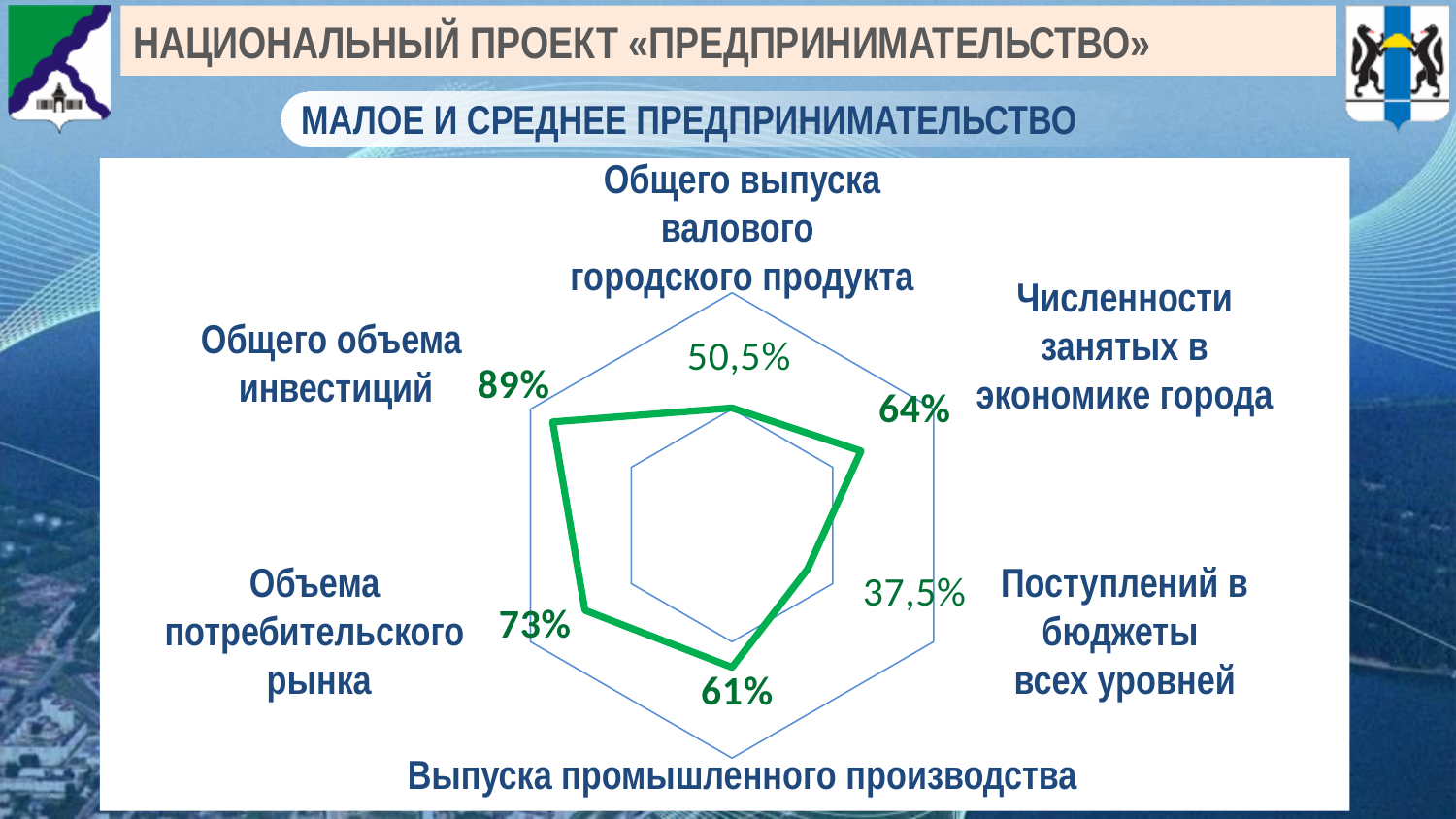
Which category on the radar chart has the lowest value? Поступлений в бюджеты всех уровней What is the difference between the value for total gross city product (50,5%) and the value for budget revenues (37,5%)? 13% How many categories (axes) does the radar chart have? 6 Which is larger: the value for employment in the city economy or the value for industrial production output? Численности занятых в экономике города What value is shown for the consumer market volume (Объема потребительского рынка)? 73% Which category on the radar chart has the highest value? Общего объема инвестиций What value is shown for industrial production output (Выпуска промышленного производства)? 61% What share of the total gross city product (Общего выпуска валового городского продукта) is shown on the radar chart? 50,5% What value is shown for the number of people employed in the city economy (Численности занятых в экономике города)? 64% What value is shown for revenues to budgets of all levels (Поступлений в бюджеты всех уровней)? 37,5% What type of chart is shown on the slide? Radar chart What is the difference between the value for total investment volume (Общего объема инвестиций) and the value for consumer market volume (Объема потребительского рынка)? 16%